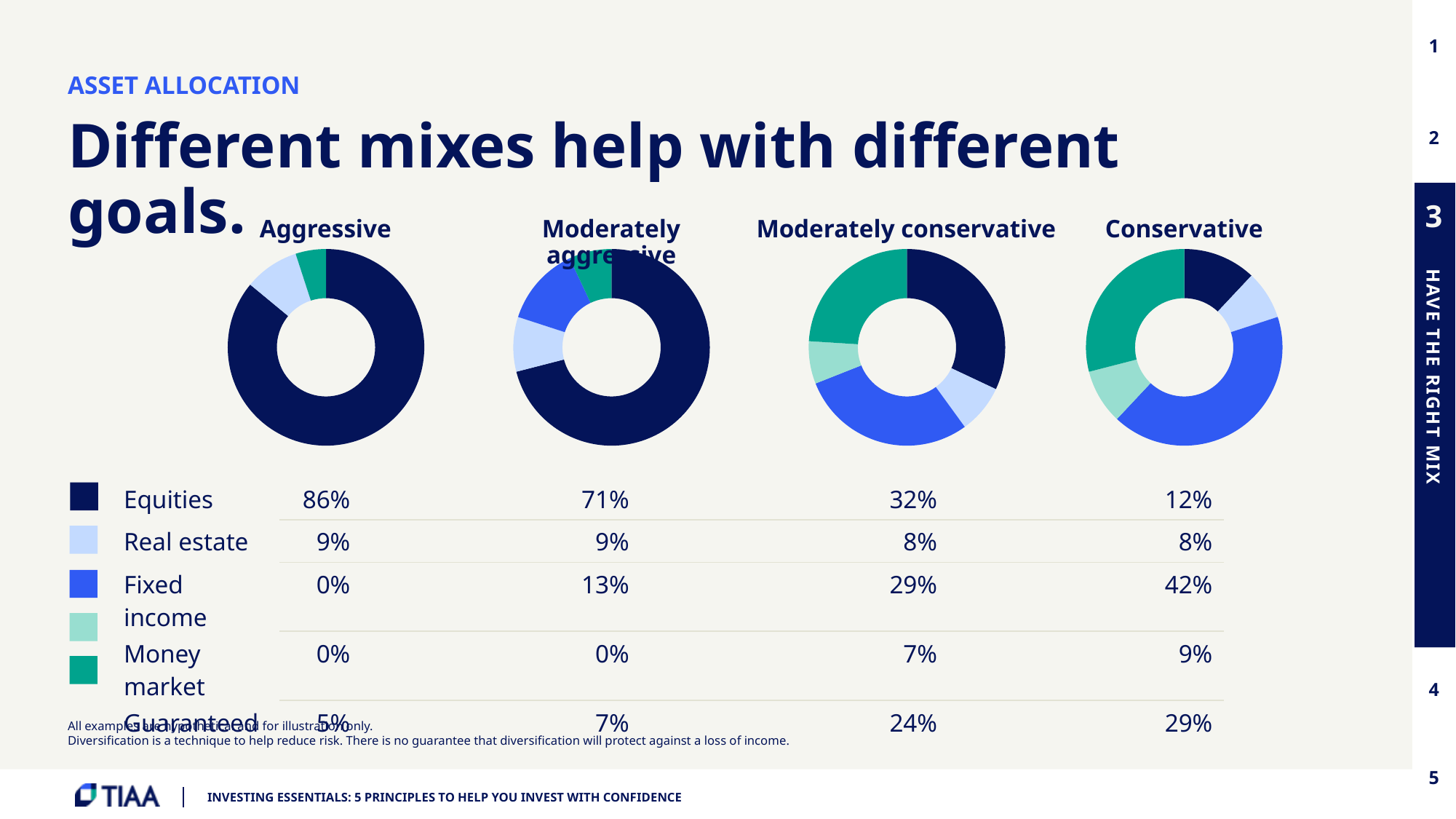
In the Conservative chart, what share is allocated to Fixed income? 42% In the Moderately aggressive chart, what share is allocated to Money market? 0% In the Moderately conservative chart, what share is allocated to Guaranteed? 24% What type of chart is used to show the Aggressive allocation? Donut chart How many asset classes does the legend list? 5 In the Moderately conservative chart, which is larger: the Equities share or the Fixed income share? Equities What is the difference between the Equities share in the Aggressive chart and the Equities share in the Moderately aggressive chart? 15% How many donut charts are shown on the slide? 4 In the Aggressive chart, what share is allocated to Equities? 86% In the Moderately conservative chart, which asset class has the smallest share? Money market Which colour represents Real estate in the legend? Light blue In the Conservative chart, which asset class has the largest share? Fixed income